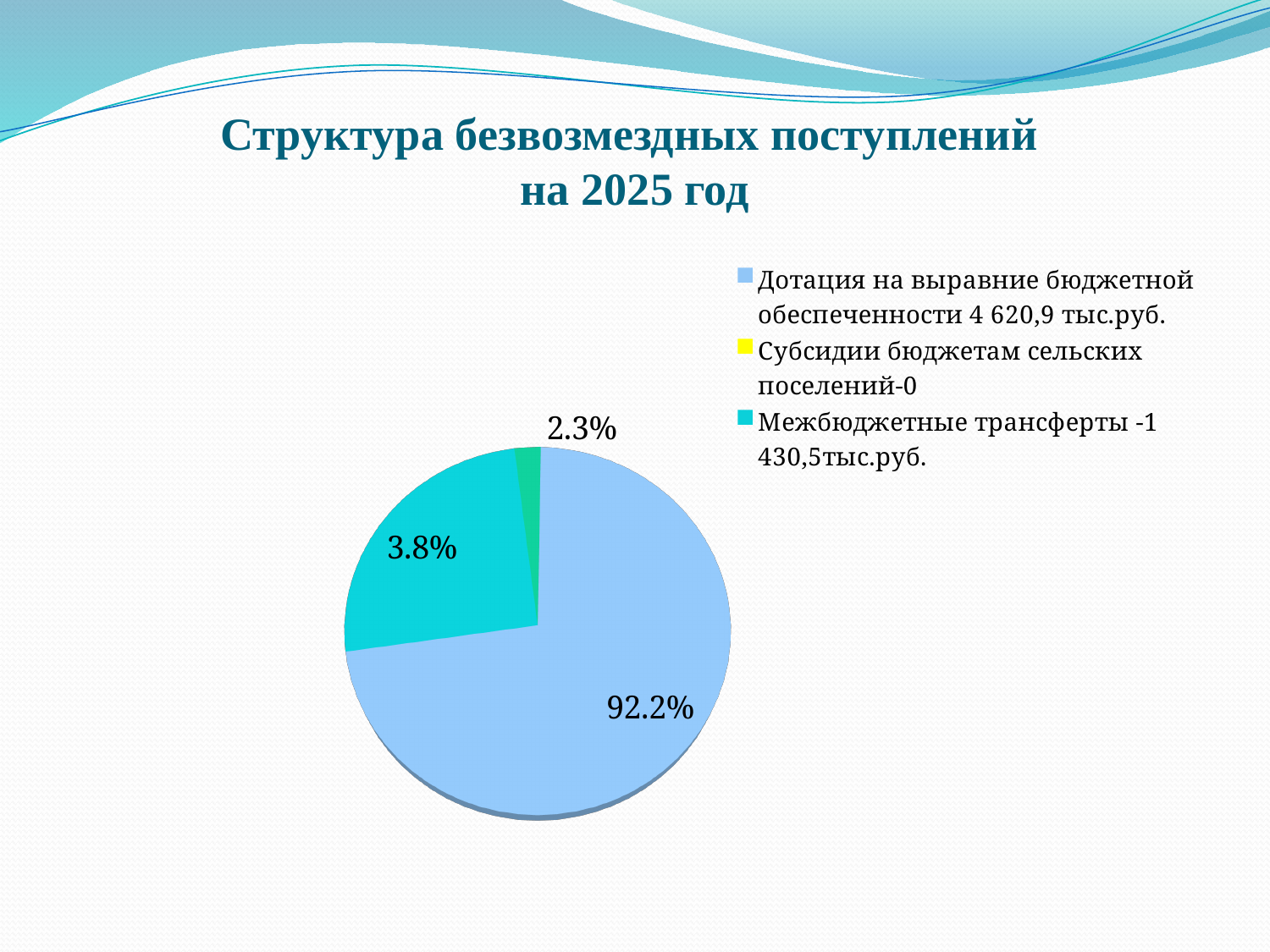
What is the smallest percentage printed on the pie chart? 2.3% What is the difference in percentage points between the 92.2% slice and the 3.8% slice? 88.4 Is the share for Дотация на выравние бюджетной обеспеченности greater or less than 50%? greater Which is larger, the 3.8% slice or the 2.3% slice? 3.8% What is the title of the slide? Структура безвозмездных поступлений на 2025 год How many percentage labels are printed on the pie chart? 3 How many entries does the legend list? 3 What kind of chart is shown on the slide? pie chart Which category has the largest slice of the pie? Дотация на выравние бюджетной обеспеченности What share of the pie is labelled for Дотация на выравние бюджетной обеспеченности? 92.2% What amount does the legend give for Дотация на выравние бюджетной обеспеченности? 4 620,9 тыс.руб. What share of the pie is labelled for Межбюджетные трансферты? 3.8%